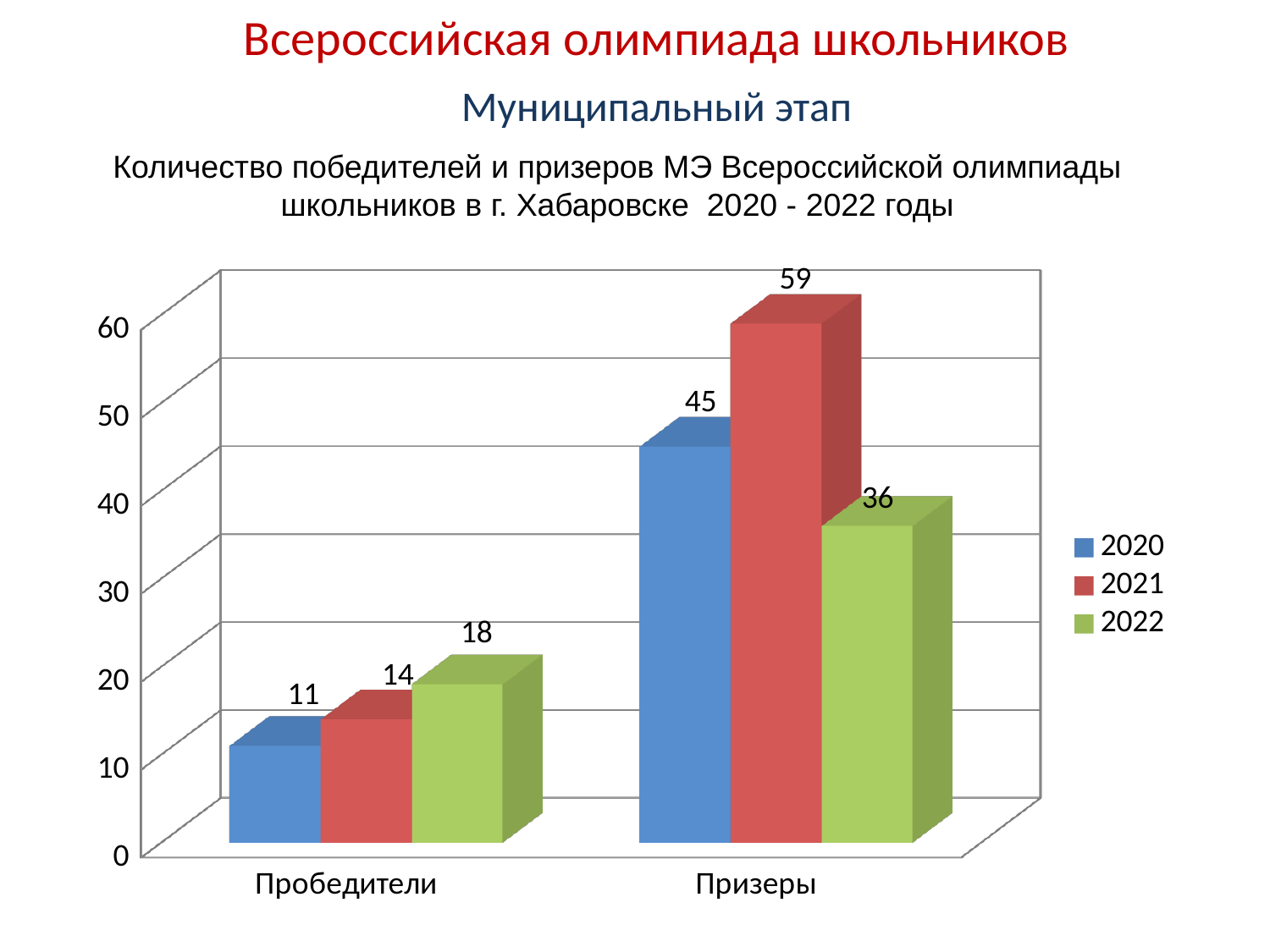
What is the difference between the 2021 and 2020 values in the Призеры category? 14 What is the value for 2022 in the Призеры category? 36 What is the value for 2020 in the Пробедители category? 11 What is the difference between the 2022 and 2020 values in the Пробедители category? 7 What kind of chart is shown on the slide? bar chart Which year has the highest value in the Призеры category? 2021 What is the value for 2021 in the Призеры category? 59 How many series does the legend list? 3 Which year has the lowest value in the Пробедители category? 2020 How many categories are shown on the x axis? 2 Which is larger: the 2022 value for Пробедители or the 2021 value for Пробедители? 2022 Which colour represents the 2022 series in the legend? green